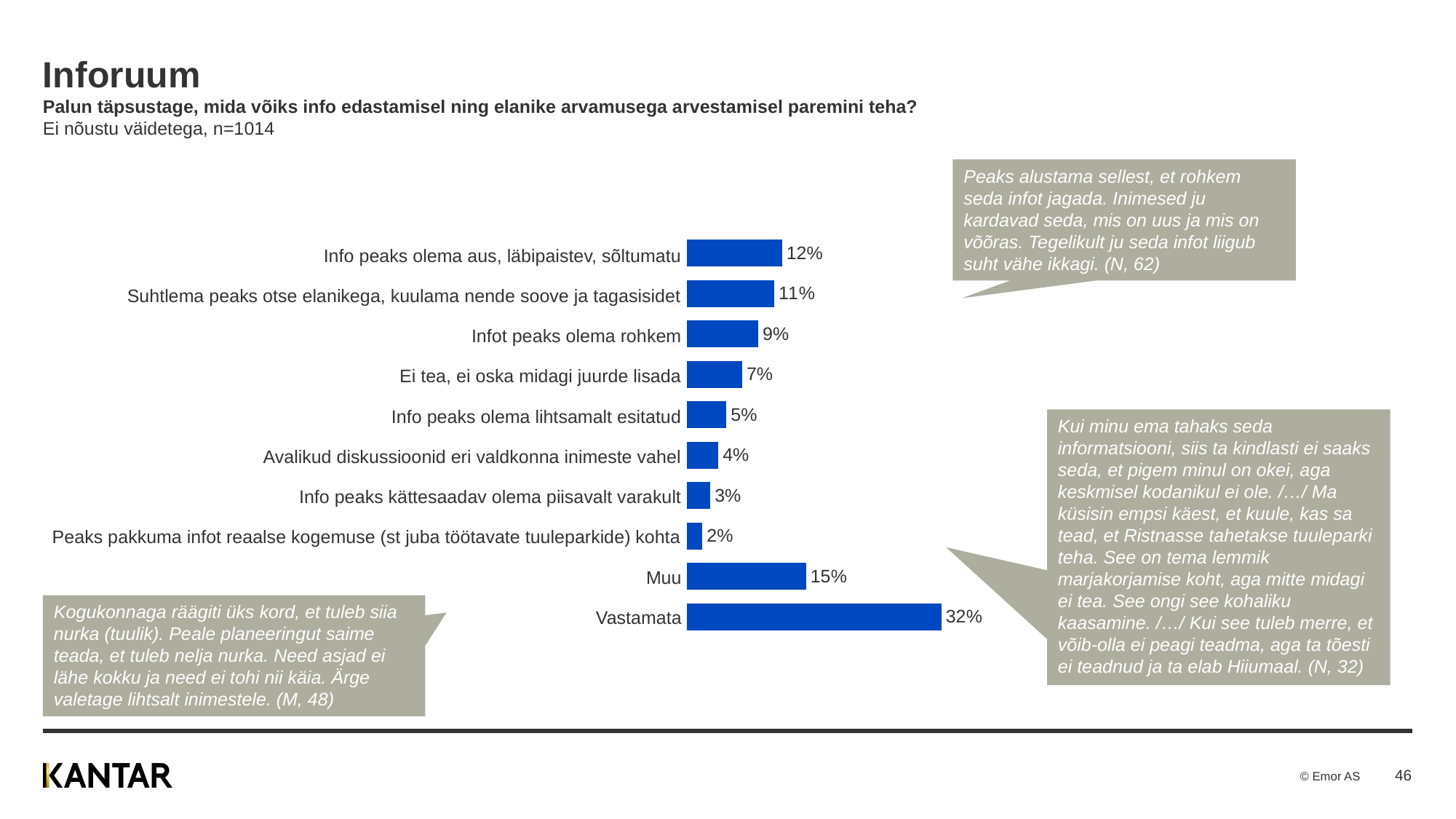
Which is larger: "Ei tea, ei oska midagi juurde lisada" or "Info peaks olema lihtsamalt esitatud"? Ei tea, ei oska midagi juurde lisada What percentage is shown for "Info peaks kättesaadav olema piisavalt varakult"? 3% How many categories are shown in the chart? 10 What is the sample size (n) stated on the slide? 1014 What colour are the bars in the chart? Blue What is the difference between "Info peaks olema aus, läbipaistev, sõltumatu" and "Infot peaks olema rohkem"? 3% What type of chart is shown on the slide? Bar chart What percentage is shown for "Infot peaks olema rohkem"? 9% What is the difference between "Vastamata" and "Muu"? 17% Which category has the highest value? Vastamata What is the value for "Muu"? 15% Which category has the lowest value? Peaks pakkuma infot reaalse kogemuse (st juba töötavate tuuleparkide) kohta